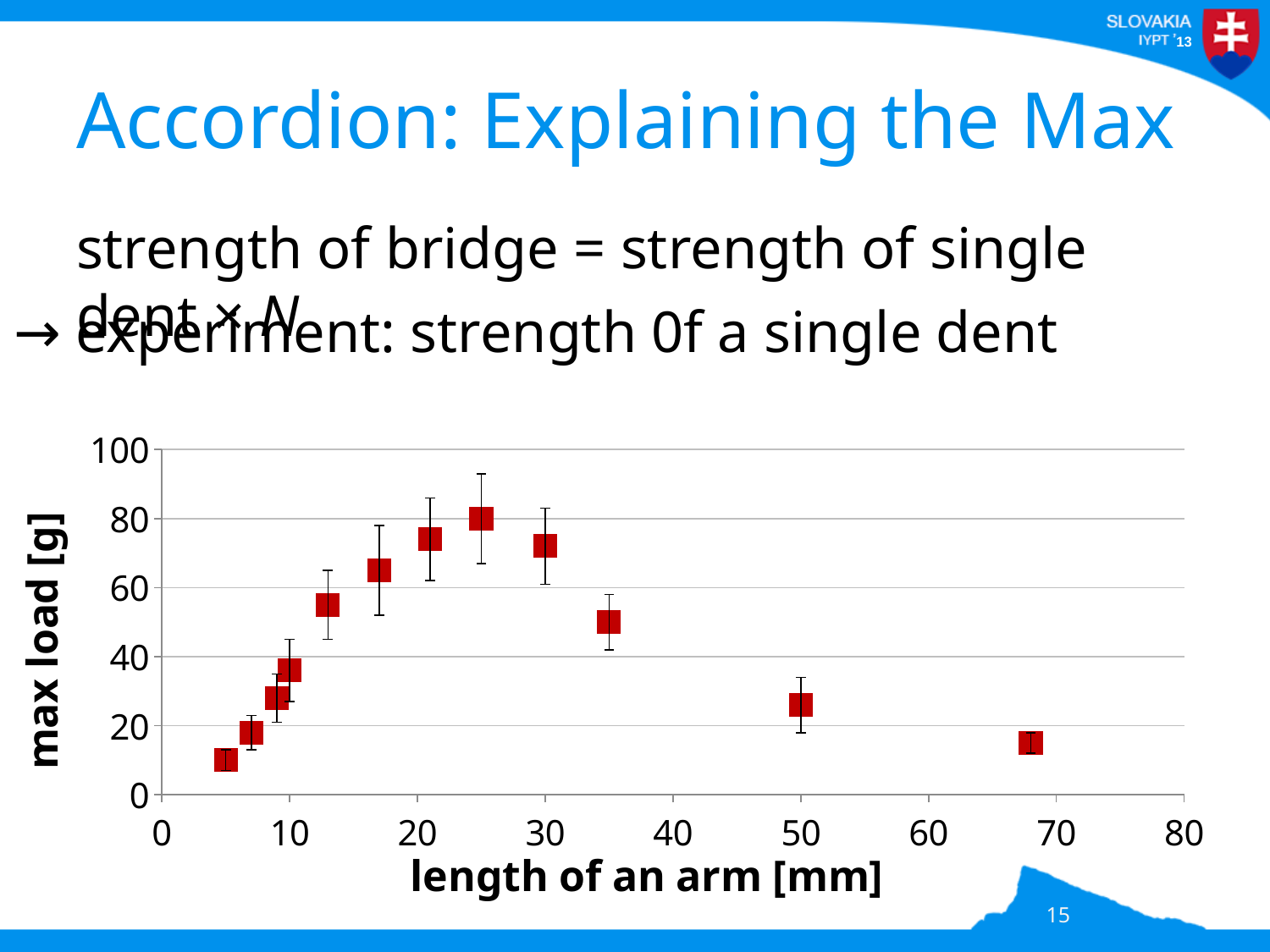
Do the max load values rise or fall as the arm length increases from about 5 mm to about 25 mm? rise What is the title of the y axis? max load [g] What is the title of the x axis? length of an arm [mm] How many data points are plotted on the chart? 12 What kind of chart is shown on the slide? scatter chart Do the max load values rise or fall as the arm length increases from about 25 mm to about 68 mm? fall Is the max load for the point at about 25 mm arm length greater or less than 60? greater Is the max load for the point at about 13 mm arm length greater or less than 40? greater Is the max load for the point at about 50 mm arm length greater or less than 40? less Which has the larger max load: the point at about 21 mm or the point at about 50 mm arm length? 21 mm